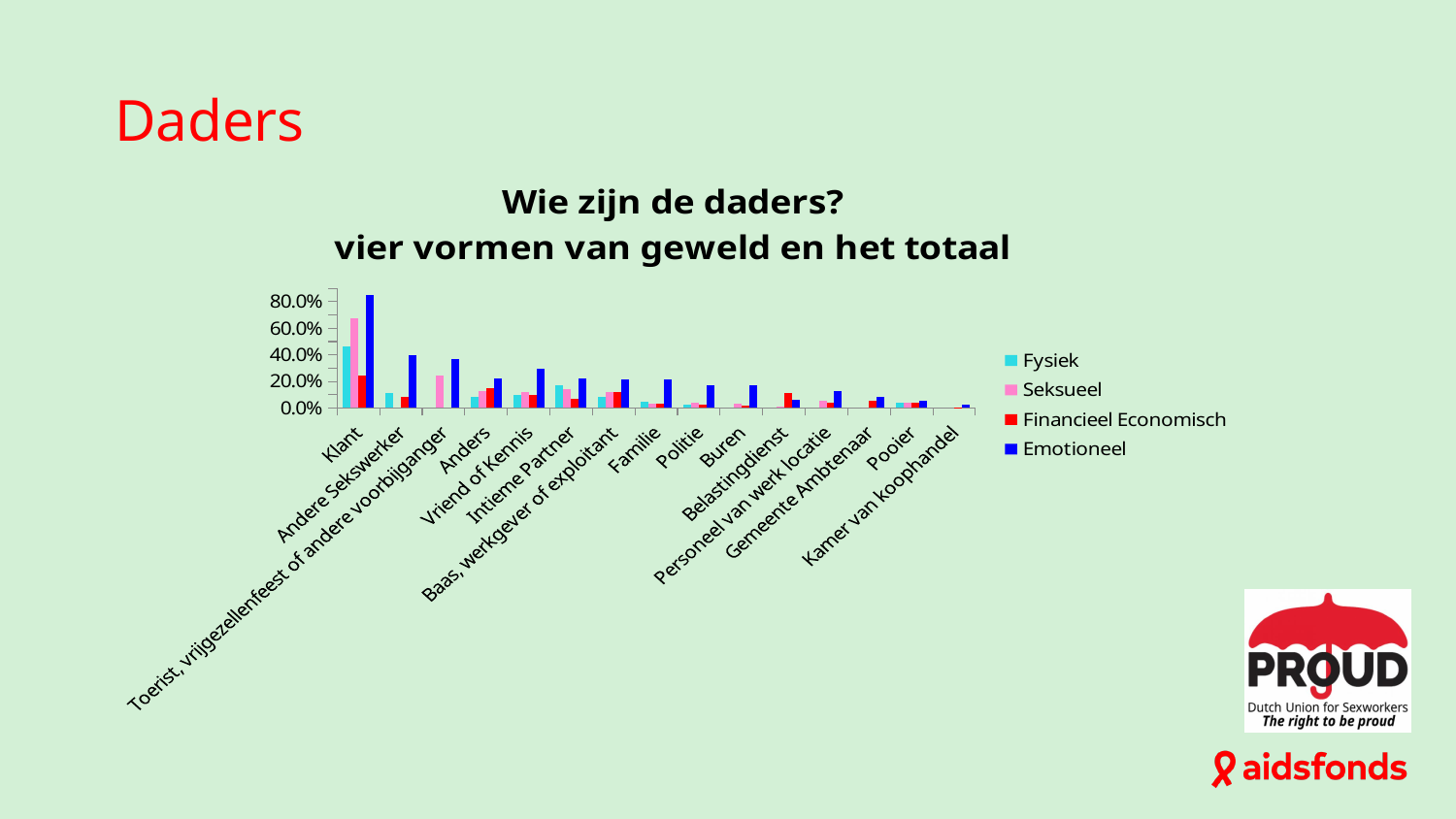
How many categories are shown along the x axis? 15 Which category has the highest Emotioneel value? Klant What kind of chart is shown on the slide? bar chart Is the Emotioneel value for Klant greater or less than 80.0%? greater For Klant, which is larger: the Seksueel value or the Emotioneel value? Emotioneel How many series does the legend list? 4 Is the Fysiek value for Klant greater or less than 40.0%? greater What is the title of the chart? Wie zijn de daders? vier vormen van geweld en het totaal Is the Emotioneel value for Kamer van koophandel greater or less than 20.0%? less Which series has the highest value for Klant? Emotioneel Do the Emotioneel values generally rise or fall from left to right along the x axis? fall